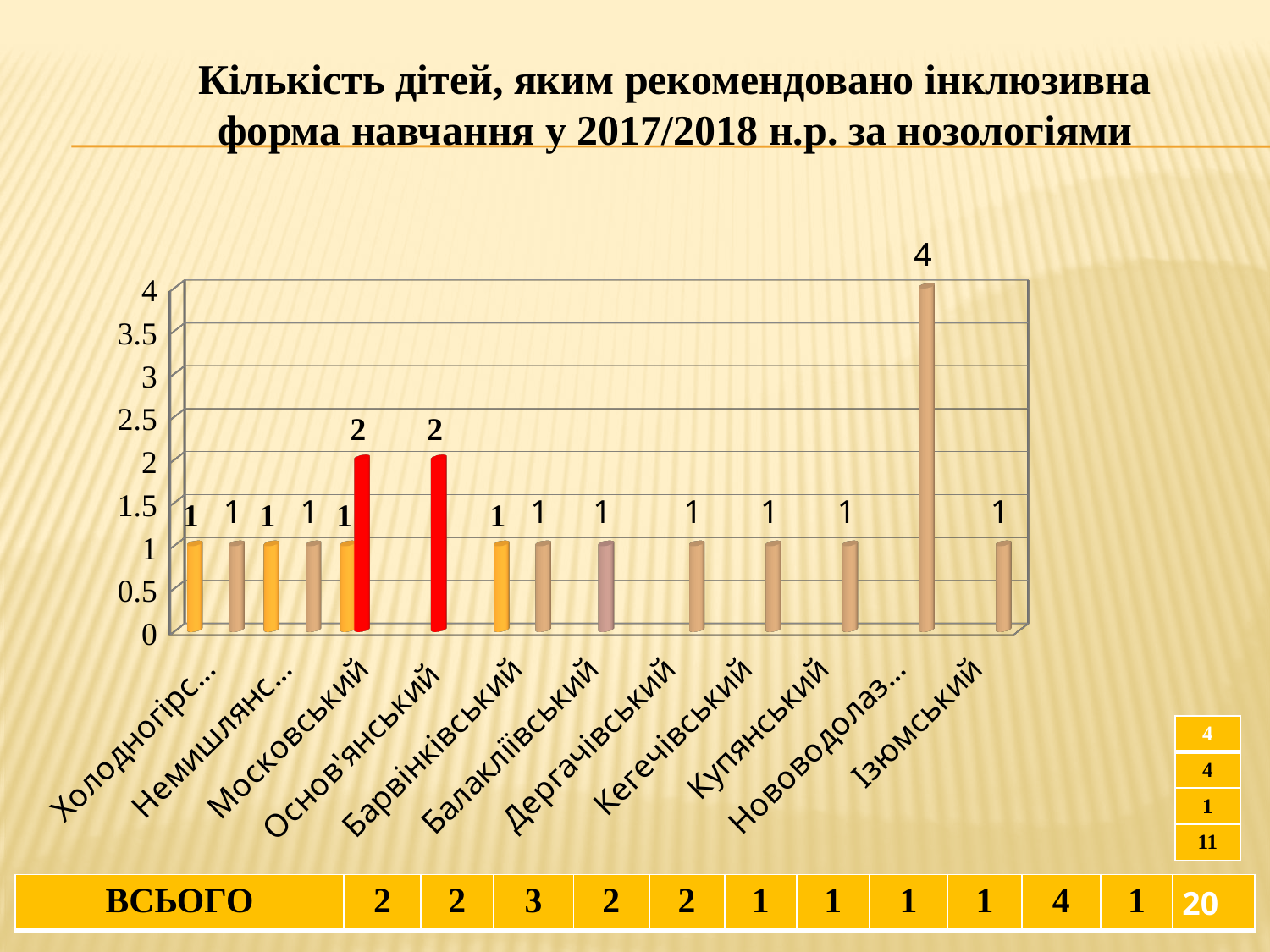
What is the difference between the bar for Нововодолаз... and the bar for Ізюмський? 3 Which district has the tallest bar in the chart? Нововодолаз... What is the value of the red bar for Основ'янський? 2 Is the value for Нововодолаз... greater or less than 3? greater What is the highest value shown on the vertical axis of the chart? 4 What kind of chart is shown on the slide? bar chart What is the value of the bar for Ізюмський? 1 What is the total (ВСЬОГО) for Московський shown in the row beneath the chart? 3 What is the overall total shown at the right end of the ВСЬОГО row? 20 What is the value of the tallest bar in the chart (for Нововодолаз...)? 4 How many district categories are shown along the x axis of the chart? 11 Which is larger: the bar for Нововодолаз... or the bar for Купянський? Нововодолаз...